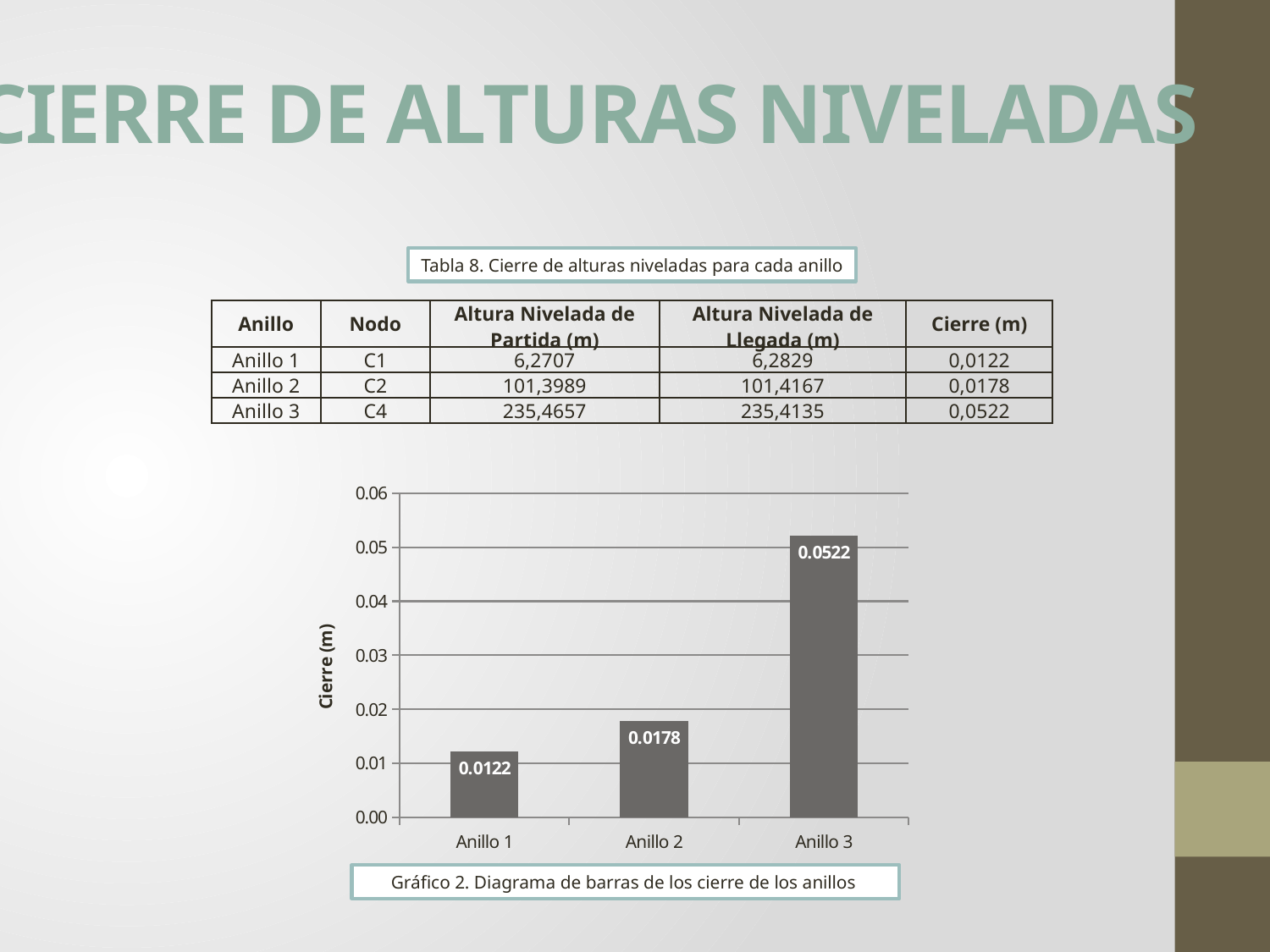
What kind of chart is shown on the slide? bar chart Is the value for Anillo 3 greater or less than 0.05? greater What is the label of the y axis of the chart? Cierre (m) Which category has the highest value in the bar chart? Anillo 3 How many categories are shown on the x axis of the bar chart? 3 What is the value for Anillo 2 in the bar chart? 0.0178 What is the difference between the values for Anillo 2 and Anillo 1? 0.0056 What is the value for Anillo 3 in the bar chart? 0.0522 Which category has the lowest value in the bar chart? Anillo 1 Which is larger, the value for Anillo 1 or the value for Anillo 2? Anillo 2 What is the difference between the values for Anillo 3 and Anillo 2? 0.0344 What is the value for Anillo 1 in the bar chart? 0.0122